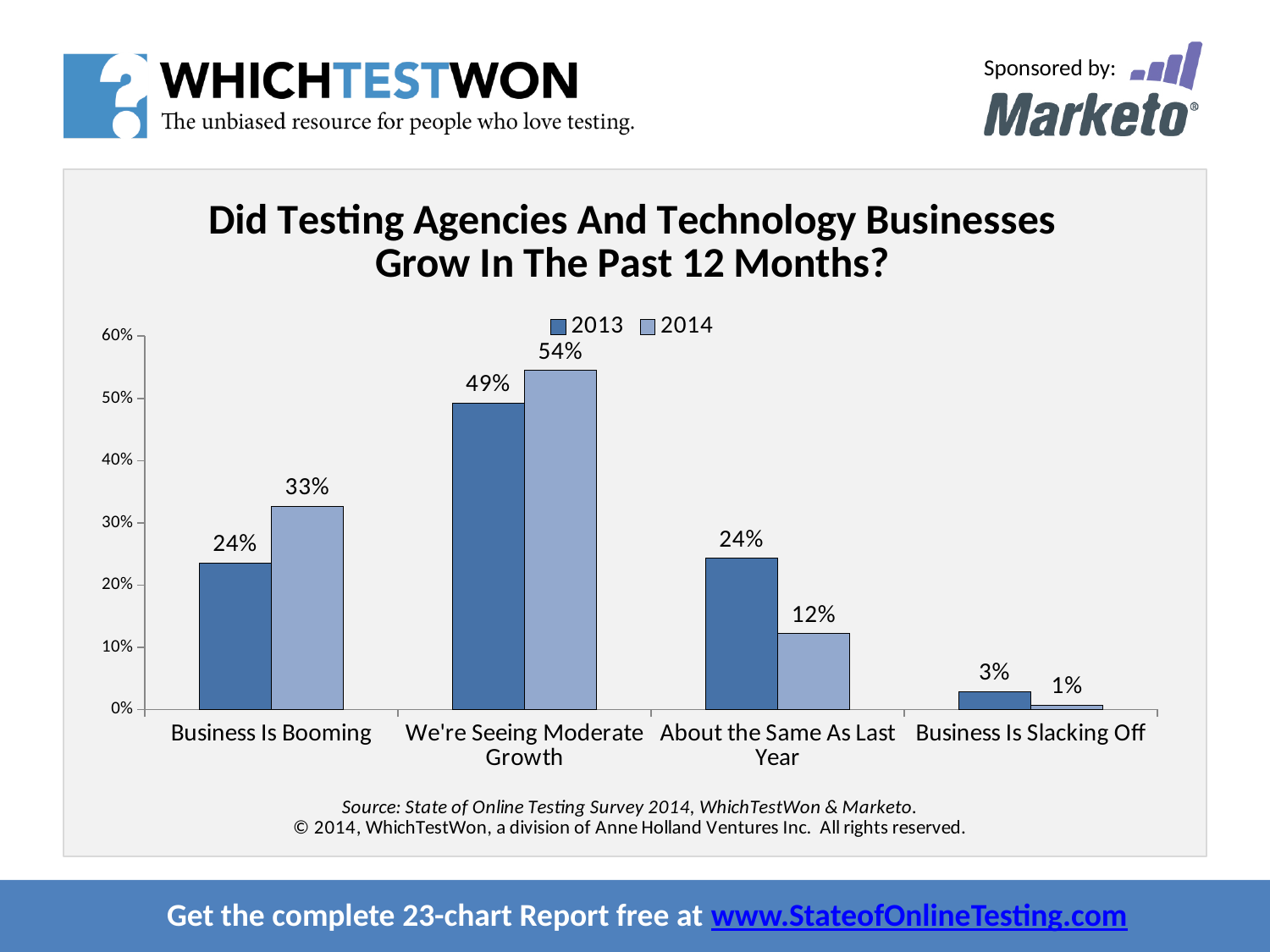
What is the 2013 value for "About the Same As Last Year"? 24% What is the 2014 value for "Business Is Booming"? 33% Which is larger for "We're Seeing Moderate Growth": the 2013 value or the 2014 value? 2014 How many series does the legend list? 2 What kind of chart is shown on the slide? Bar chart What is the difference between the 2014 and 2013 values for "Business Is Booming"? 9% How many categories are shown on the x axis? 4 Which category has the highest 2014 value? We're Seeing Moderate Growth What is the title of the chart? Did Testing Agencies And Technology Businesses Grow In The Past 12 Months? What is the difference between the 2013 and 2014 values for "About the Same As Last Year"? 12% What is the 2014 value for "We're Seeing Moderate Growth"? 54% Which category has the lowest 2013 value? Business Is Slacking Off